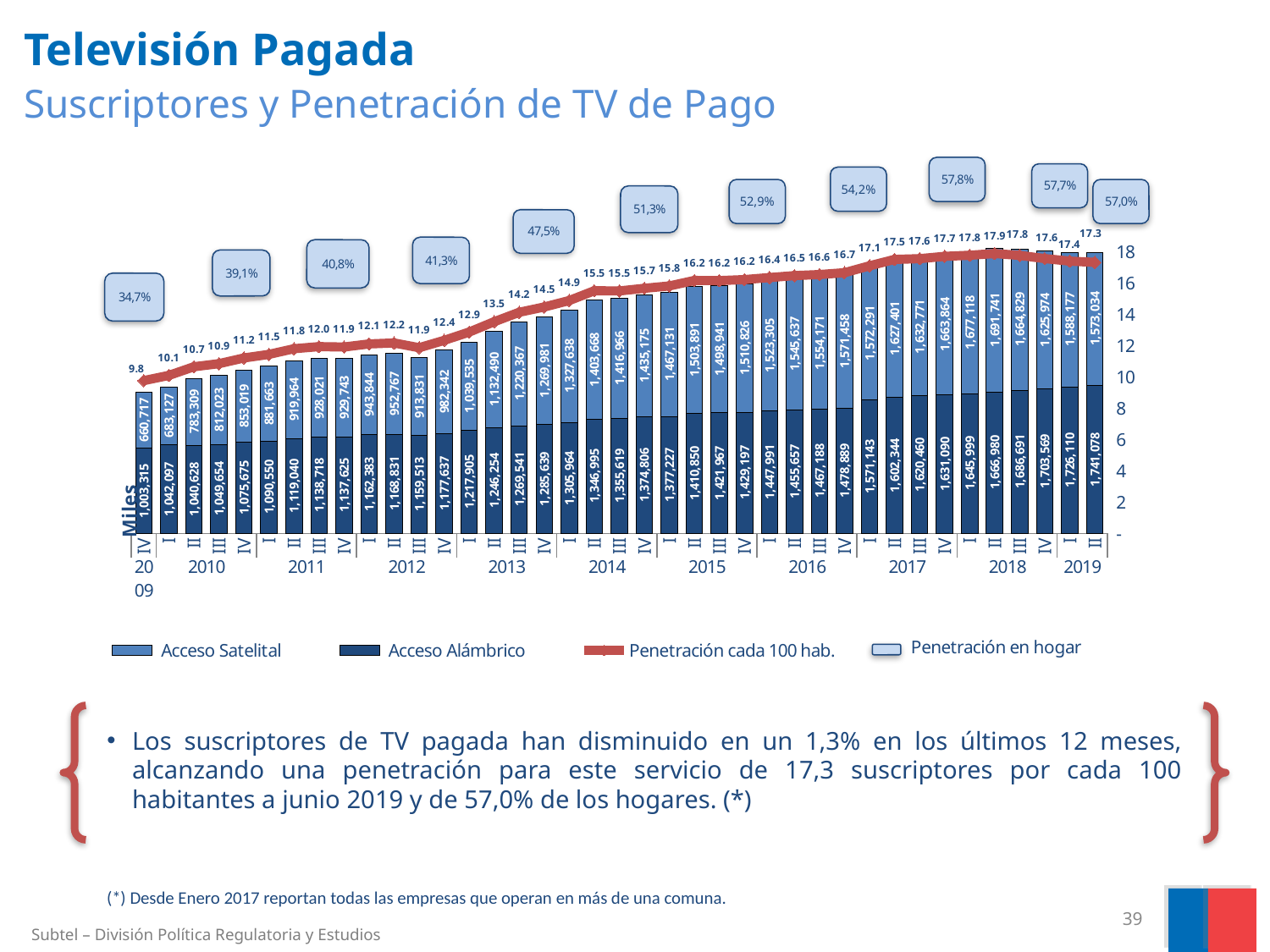
What is the highest value reached by the Penetración cada 100 hab. line? 17.9 What is the Penetración cada 100 hab. value for IV 2009? 9.8 What is the Penetración en hogar value shown for 2019? 57,0% What is the Acceso Satelital value for II 2019? 1,573,034 What is the lowest Penetración en hogar value shown? 34,7% What is the Acceso Alámbrico value for II 2019? 1,741,078 Which year has the highest Penetración en hogar value? 2017 Does the Acceso Alámbrico series generally rise or fall from IV 2009 to II 2019? rise What is the difference between the Acceso Alámbrico values for II 2019 and I 2019? 14,968 In II 2019, which is larger: Acceso Alámbrico or Acceso Satelital? Acceso Alámbrico What is the total of the stacked bar for II 2019 (Acceso Alámbrico plus Acceso Satelital)? 3,314,112 How many series does the legend list? 4